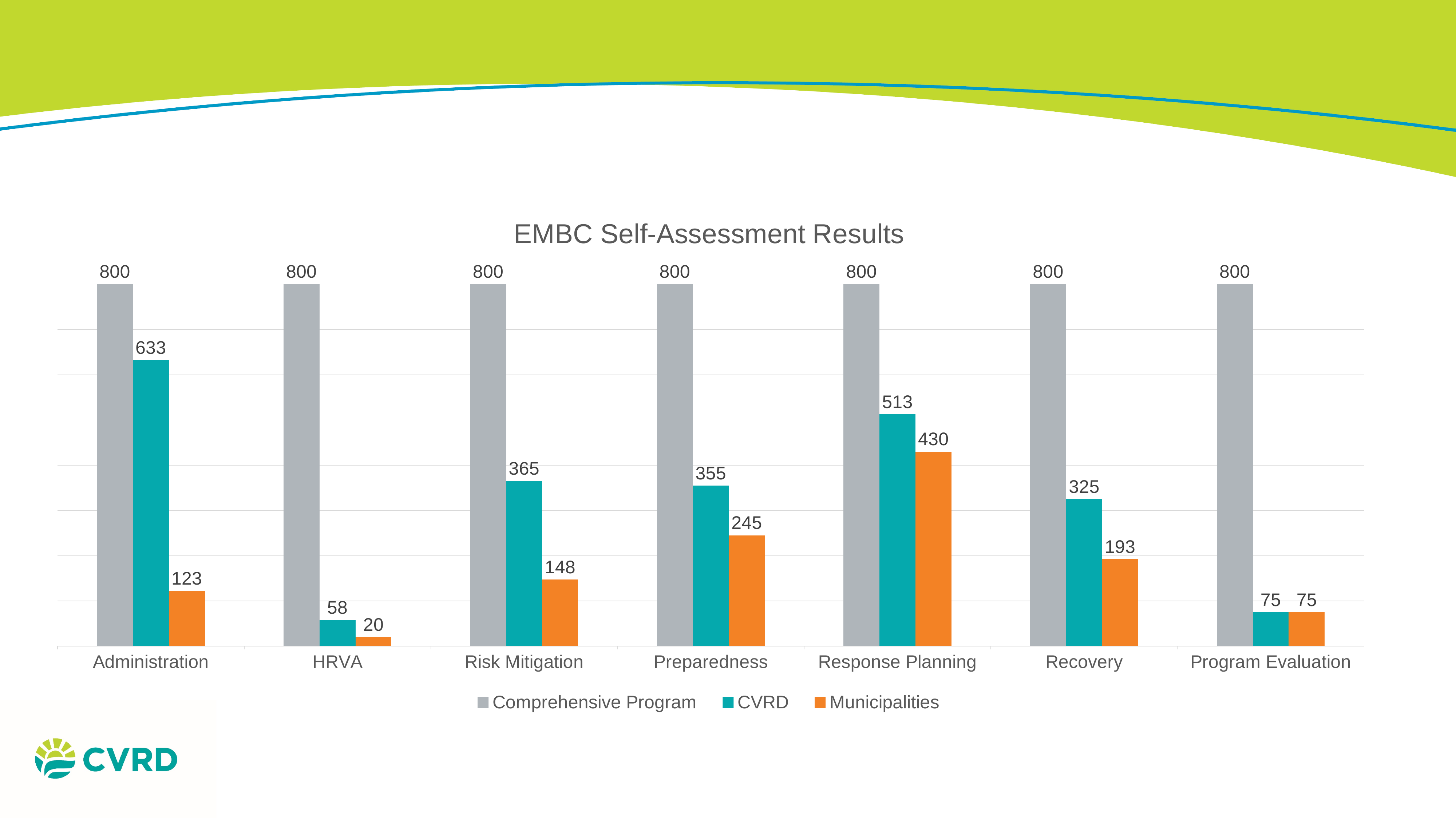
What is the Municipalities value for Response Planning? 430 Which category has the highest CVRD value? Administration Which is larger for Preparedness, the CVRD value or the Municipalities value? CVRD What is the Municipalities value for Program Evaluation? 75 How many categories are shown on the x axis? 7 Which category has the lowest Municipalities value? HRVA What is the title of the chart? EMBC Self-Assessment Results What is the Comprehensive Program value for HRVA? 800 How many series does the legend list? 3 What is the CVRD value for Administration? 633 What is the difference between the CVRD and Municipalities values for Recovery? 132 What kind of chart is shown? Bar chart